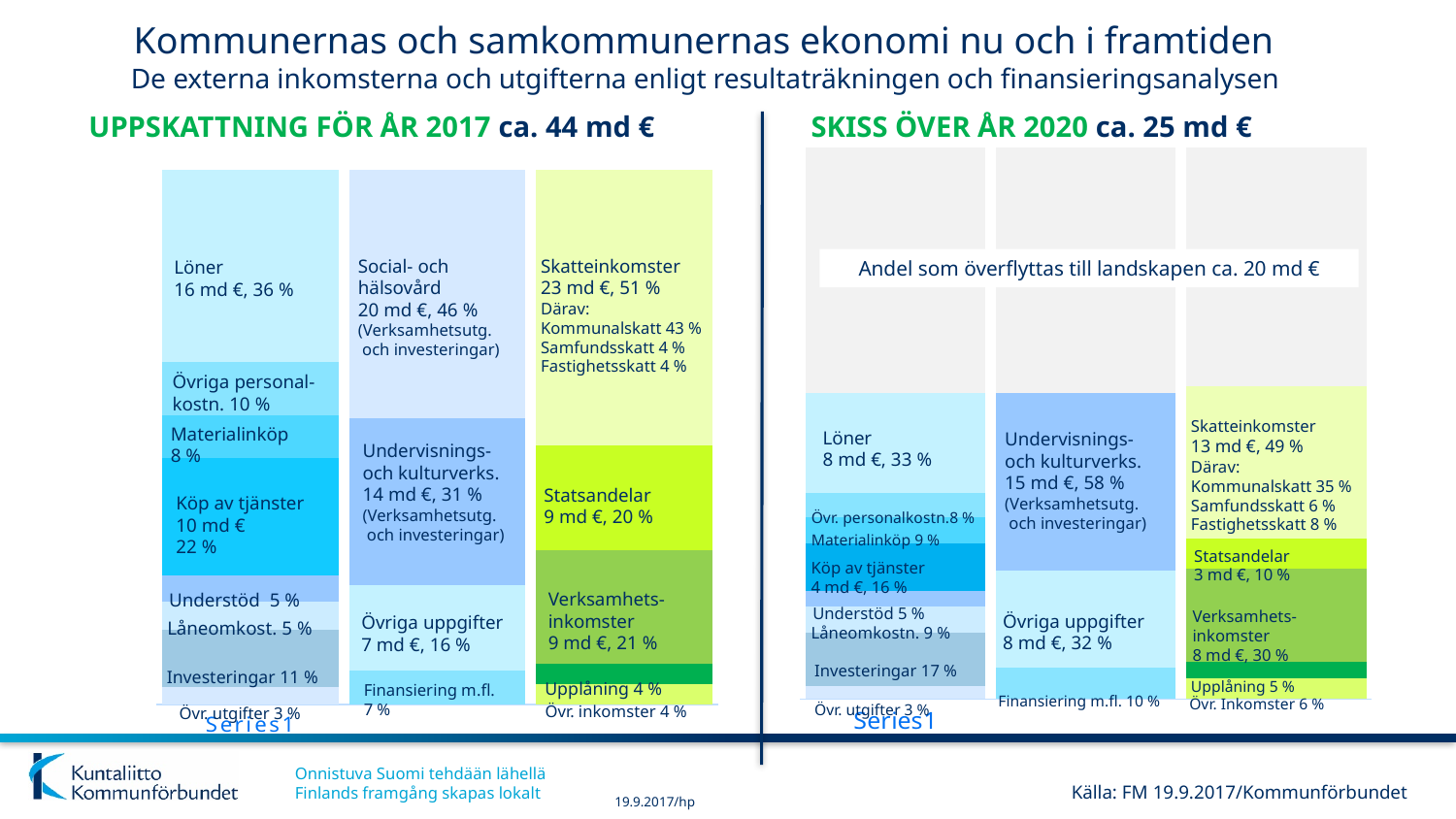
In the 2020 chart, what percentage is Kommunalskatt within Skatteinkomster? 35 % In the 2017 chart, what is the difference in percentage points between Skatteinkomster (51 %) and Statsandelar (20 %)? 31 percentage points In the 2017 chart, what is the value for Skatteinkomster in md €? 23 md € How many bars does the 2020 chart (SKISS ÖVER ÅR 2020) contain? 3 In the 2017 chart, which is larger: Social- och hälsovård or Undervisnings- och kulturverks.? Social- och hälsovård What kind of chart is used on the slide? Stacked bar chart In the 2020 chart (SKISS ÖVER ÅR 2020), what is the value for Undervisnings- och kulturverks. in md €? 15 md € In the 2020 chart, what percentage is Statsandelar? 10 % In the 2017 chart (UPPSKATTNING FÖR ÅR 2017), what share of the bar is Löner? 36 % According to the 2020 chart, how much is the share transferred to the regions (landskapen)? ca. 20 md € In the 2020 chart, which is larger: Verksamhetsinkomster or Statsandelar? Verksamhetsinkomster In the 2017 chart, what percentage is Social- och hälsovård? 46 %